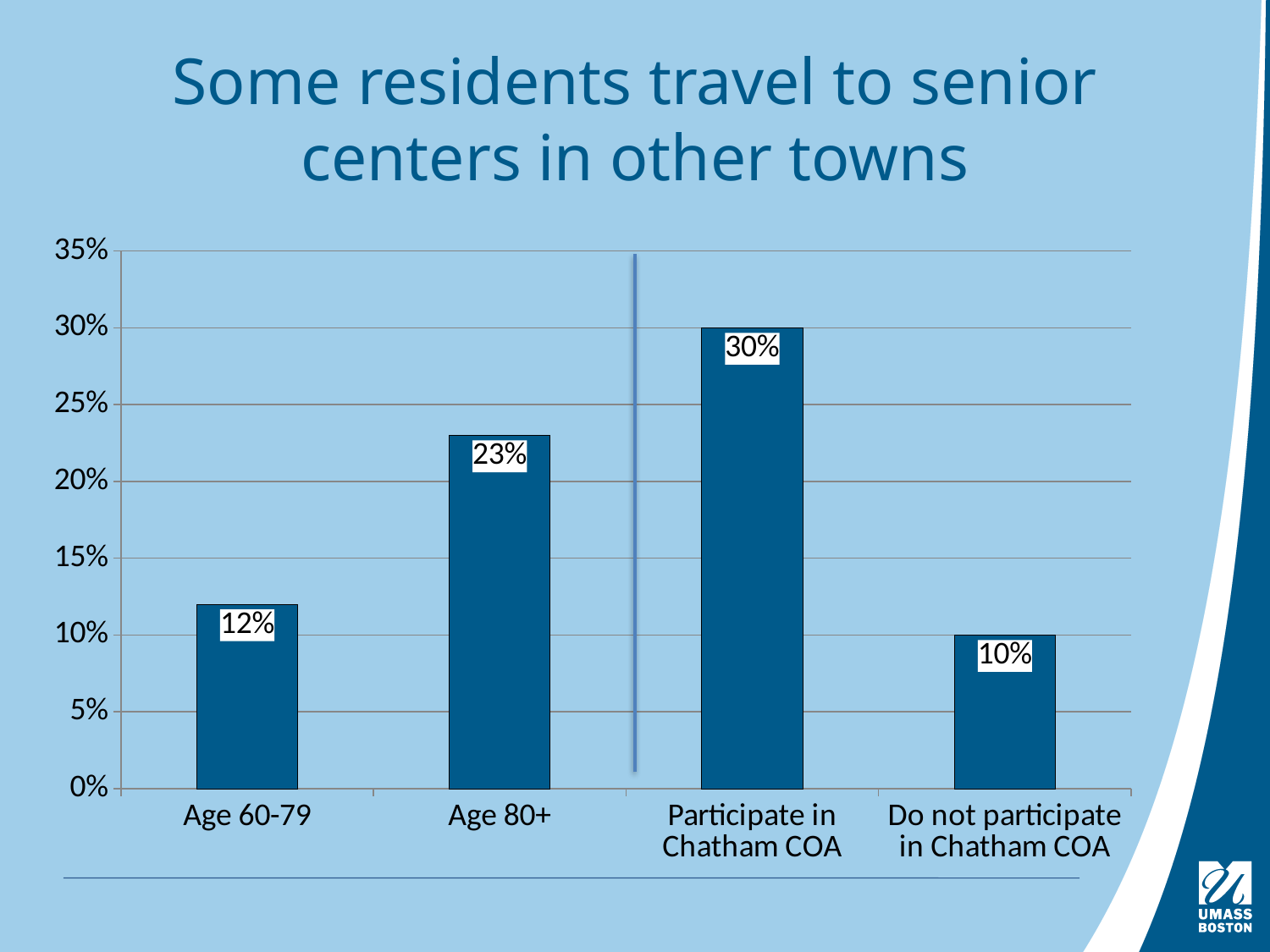
Which category has the lowest value? Do not participate in Chatham COA What is the value for Age 80+? 23% Which category has the highest value? Participate in Chatham COA What is the difference between the values for Age 80+ and Age 60-79? 11% How many categories are shown on the chart? 4 Which is larger, the value for Age 80+ or the value for Do not participate in Chatham COA? Age 80+ What is the value for Participate in Chatham COA? 30% What is the difference between the values for Participate in Chatham COA and Do not participate in Chatham COA? 20% What kind of chart is shown on the slide? Bar chart What is the value for Age 60-79? 12% What is the title of the slide? Some residents travel to senior centers in other towns What is the value for Do not participate in Chatham COA? 10%